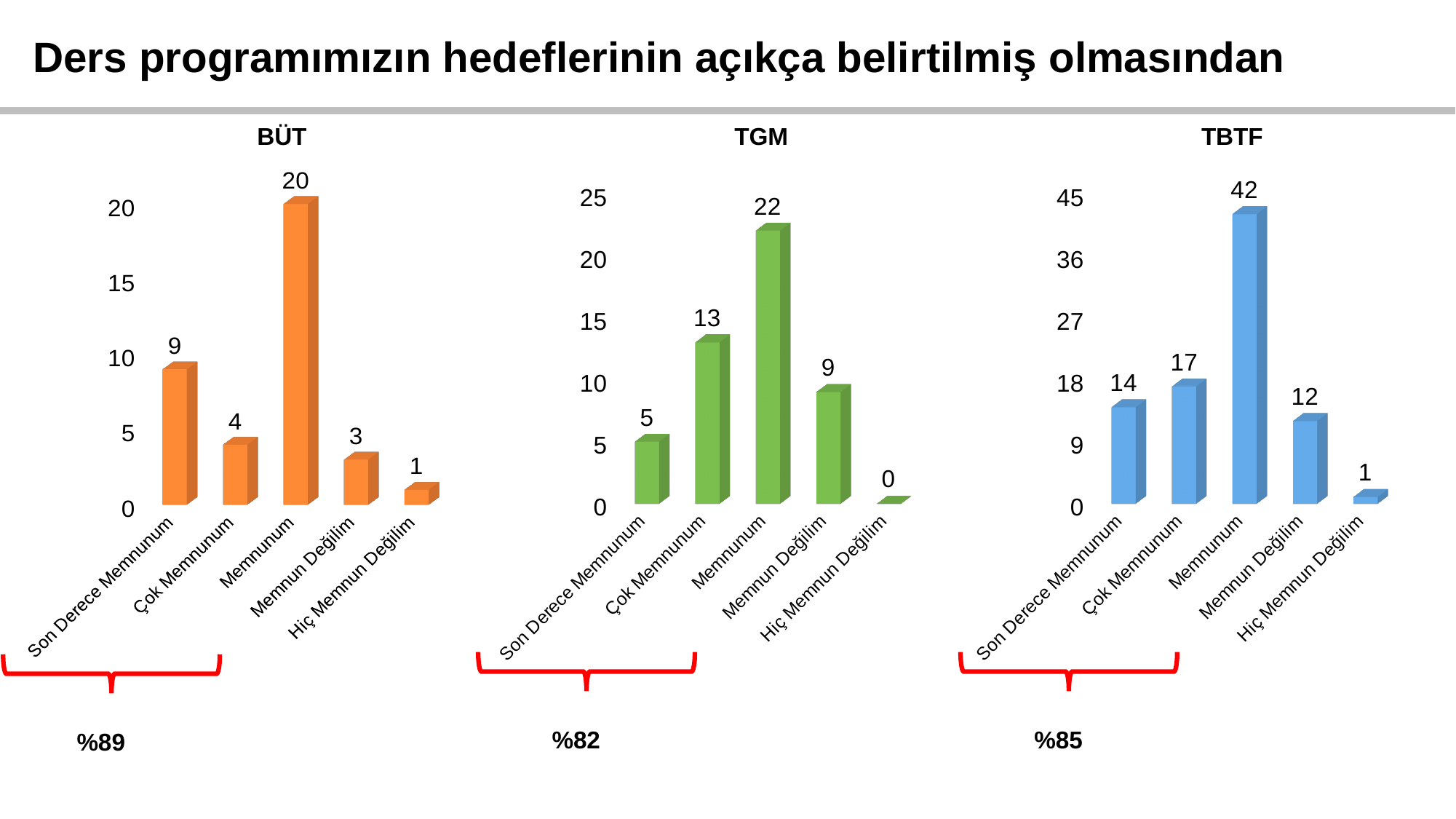
What kind of chart is the TGM chart? bar chart In the TGM chart, which category has the lowest value? Hiç Memnun Değilim In the TBTF chart, what is the value for Memnun Değilim? 12 What colour are the bars in the TBTF chart? blue How many categories does the BÜT chart show? 5 In the TGM chart, what is the value for Çok Memnunum? 13 In the TGM chart, which is larger, the value for Son Derece Memnunum or the value for Memnun Değilim? Memnun Değilim In the BÜT chart, what is the value for Memnunum? 20 In the TBTF chart, which category has the highest value? Memnunum In the TBTF chart, is the value for Memnunum greater or less than 36? greater In the BÜT chart, what is the difference between the values for Memnunum and Son Derece Memnunum? 11 In the TBTF chart, what is the difference between the values for Çok Memnunum and Son Derece Memnunum? 3